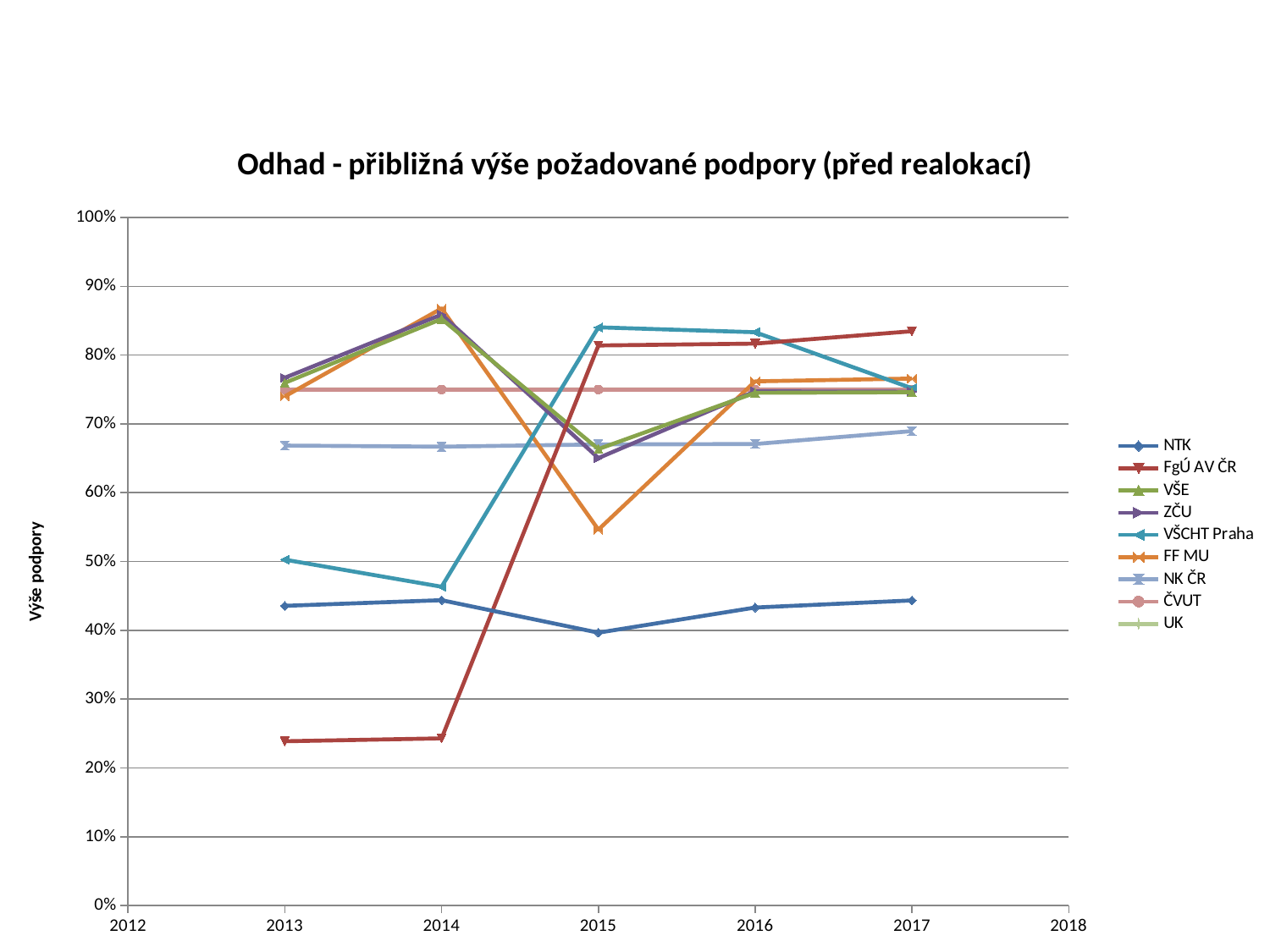
Is the value for ZČU in 2014 greater or less than 80%? greater Which series has the highest value in 2017? FgÚ AV ČR Is the value for FgÚ AV ČR in 2013 greater or less than 30%? less Is the value for FF MU in 2015 greater or less than 60%? less Which series has the lowest value in 2015? NTK What kind of chart is shown on the slide? line chart How many series does the legend list? 9 Does the FgÚ AV ČR series rise or fall overall from 2013 to 2017? rise In 2015, which is higher: FF MU or NK ČR? NK ČR How many years have data points plotted on the chart? 5 Which series has the lowest value in 2013? FgÚ AV ČR